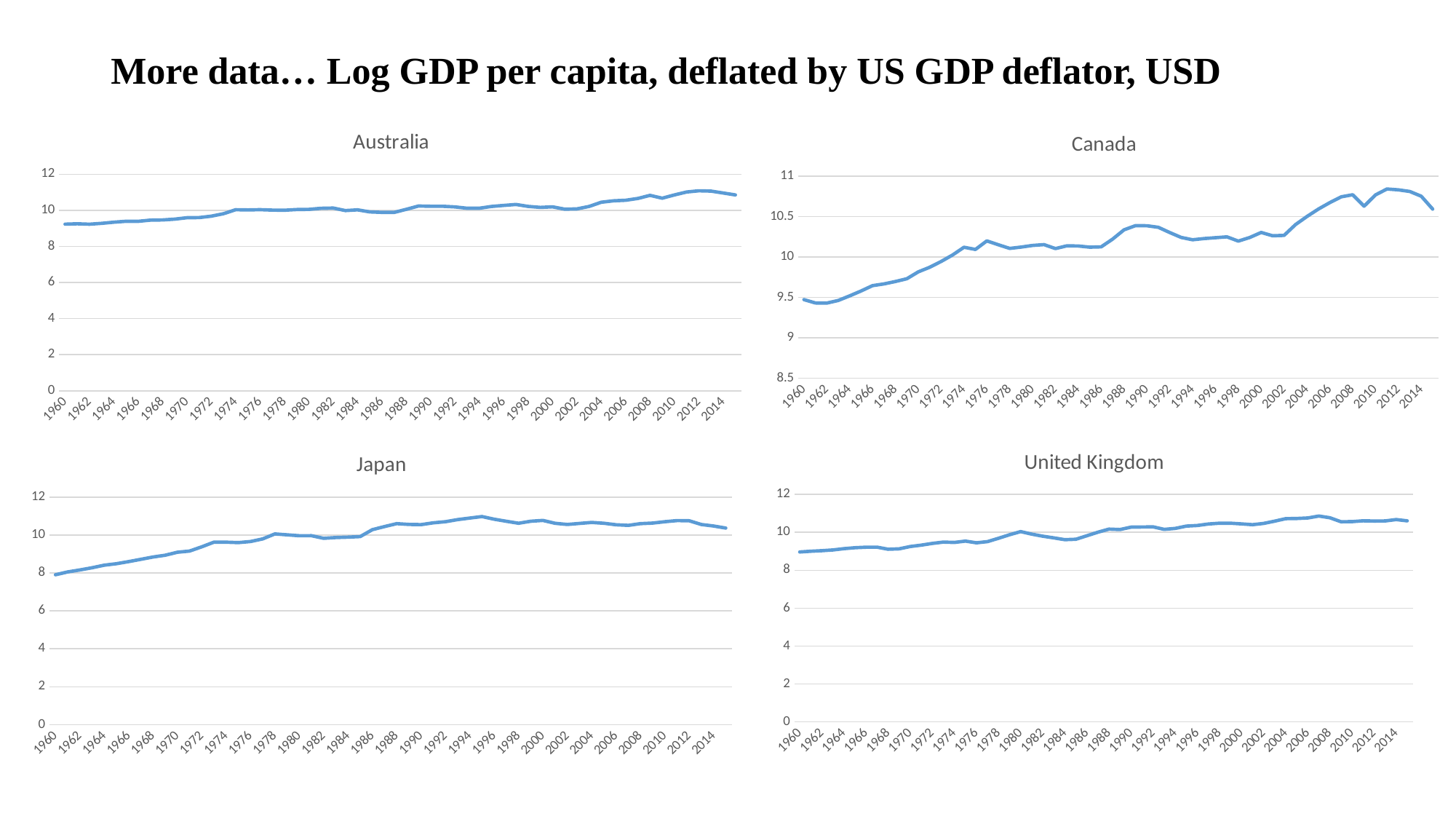
How many charts are shown on the slide? 4 In the United Kingdom chart, is the value for 1960 greater or less than 10? less How many series does the Canada chart plot? 1 In the Japan chart, does the value rise or fall overall from 1960 to 1996? rise In the United Kingdom chart, does the value rise or fall overall from 1960 to 2014? rise In the Australia chart, is the value for 2012 greater or less than 10? greater In the Canada chart, does the value rise or fall from 2012 to the last year shown? fall In the Canada chart, is the value for 1960 greater or less than 10? less What kind of chart is the Australia chart? line chart What is the lowest value shown on the vertical axis of the Canada chart? 8.5